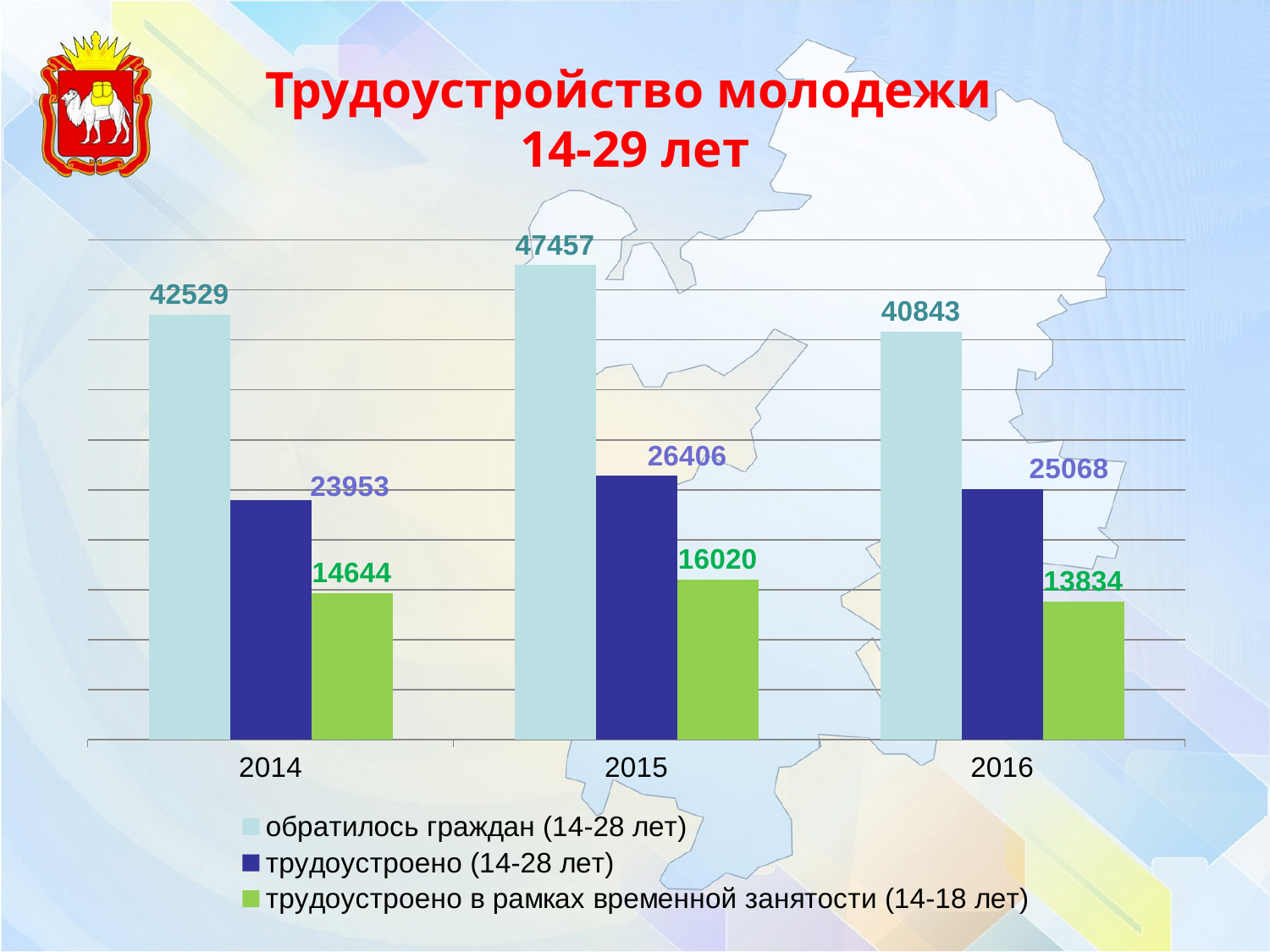
What is the value for "обратилось граждан (14-28 лет)" in 2015? 47457 In which year was the value for "трудоустроено в рамках временной занятости (14-18 лет)" lowest? 2016 In which year was the value for "обратилось граждан (14-28 лет)" highest? 2015 What is the difference between "обратилось граждан (14-28 лет)" and "трудоустроено (14-28 лет)" in 2016? 15775 What is the value for "трудоустроено в рамках временной занятости (14-18 лет)" in 2016? 13834 How many years are shown on the x axis? 3 What kind of chart is shown on the slide? bar chart What is the title of the chart? Трудоустройство молодежи 14-29 лет What is the value for "трудоустроено (14-28 лет)" in 2014? 23953 Does the value for "обратилось граждан (14-28 лет)" rise or fall from 2015 to 2016? fall How many series does the legend list? 3 Which is larger: "трудоустроено (14-28 лет)" in 2015 or in 2016? 2015